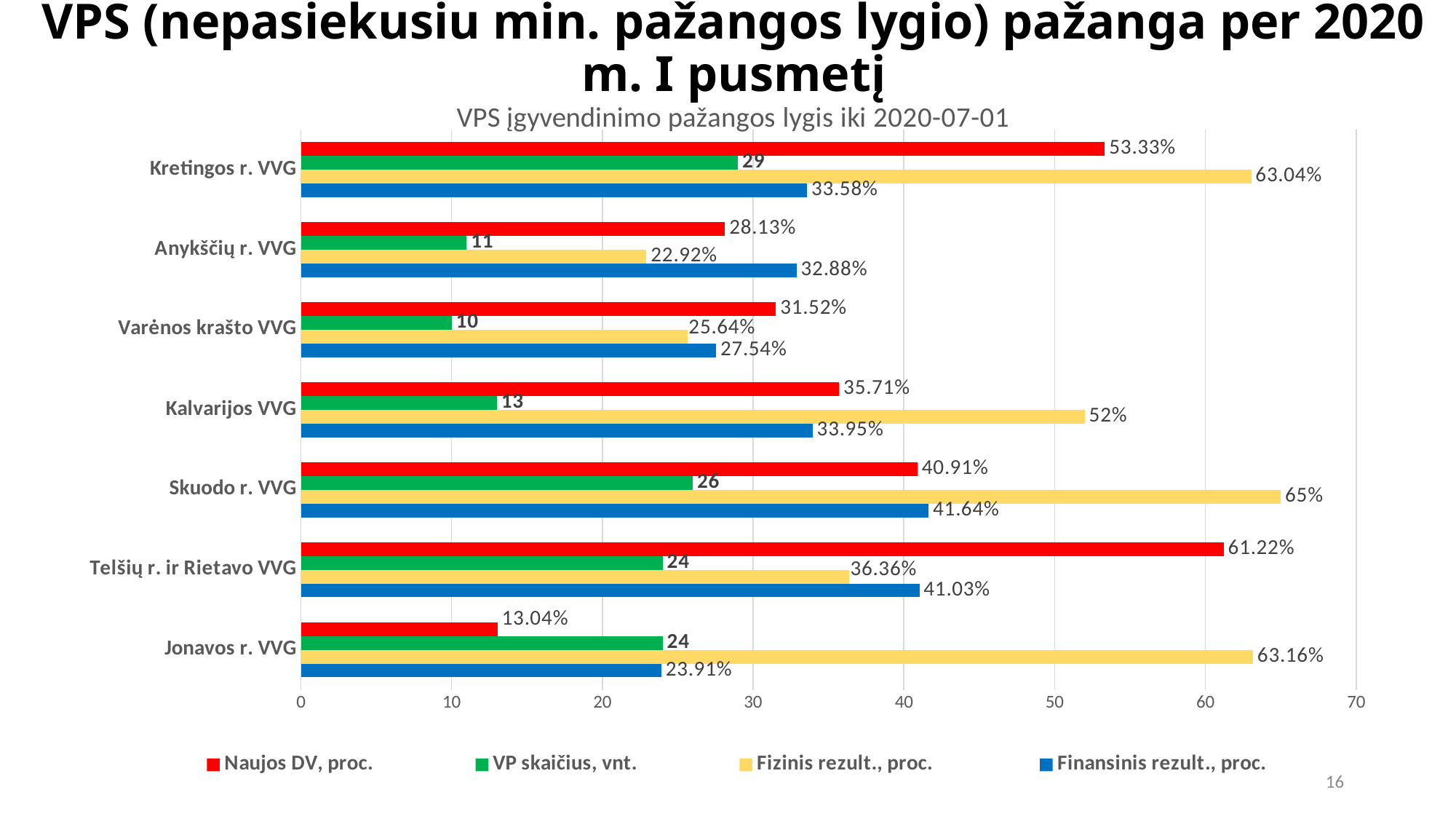
Which VVG has the lowest Naujos DV, proc. value? Jonavos r. VVG Which has a larger Naujos DV, proc. value: Telšių r. ir Rietavo VVG or Kalvarijos VVG? Telšių r. ir Rietavo VVG What is the difference between the Fizinis rezult., proc. values of Kretingos r. VVG and Anykščių r. VVG? 40.12% How many VVG categories are shown on the chart? 7 What kind of chart is shown on the slide? bar chart What is the value of Naujos DV, proc. for Kretingos r. VVG? 53.33% Which VVG has the highest Fizinis rezult., proc. value? Skuodo r. VVG What is the Finansinis rezult., proc. value for Jonavos r. VVG? 23.91% How many series does the legend list? 4 Which VVG has the highest VP skaičius, vnt. value? Kretingos r. VVG Is the Fizinis rezult., proc. value for Kalvarijos VVG greater or less than 50? greater What is the VP skaičius, vnt. value for Skuodo r. VVG? 26